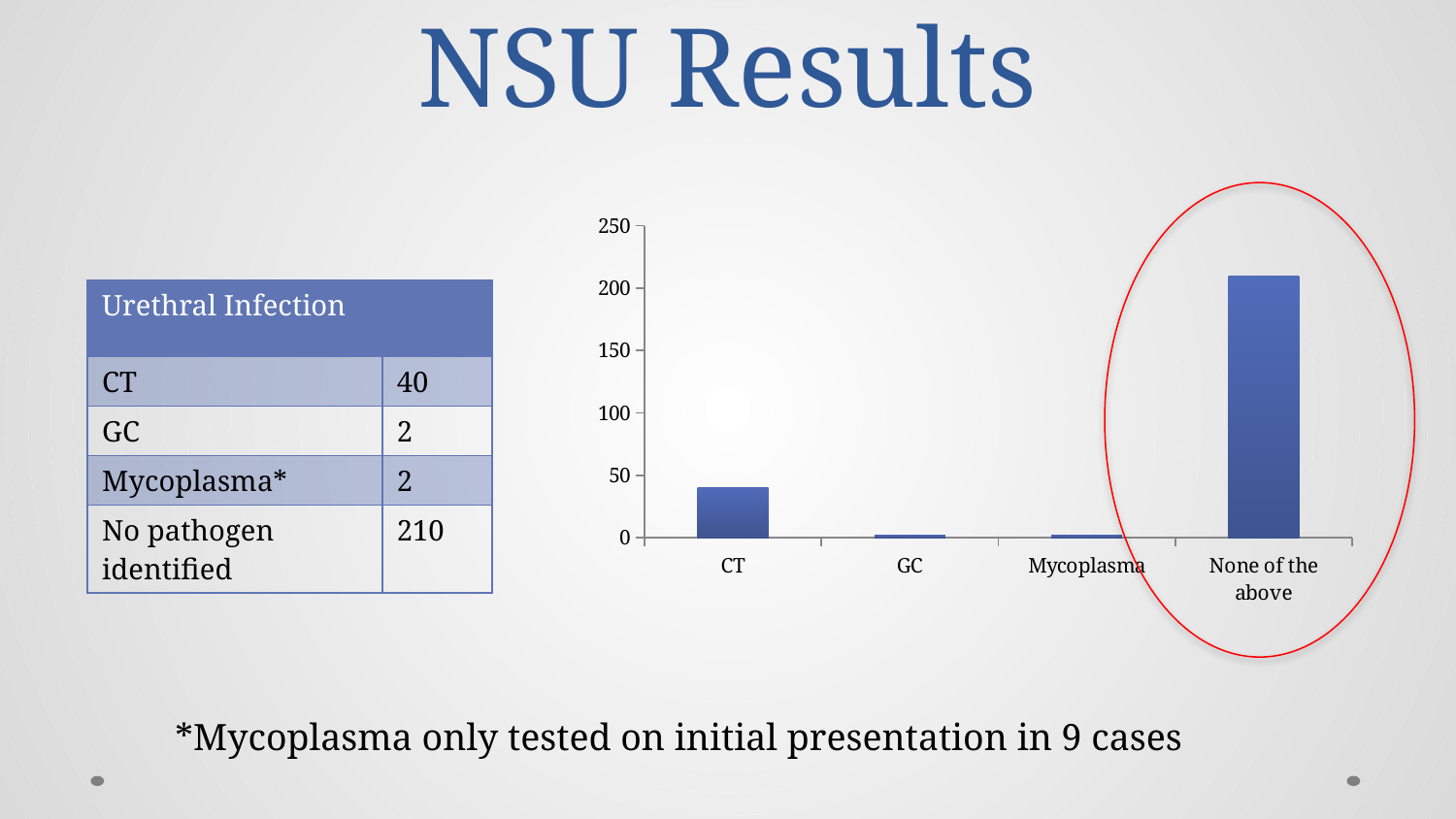
According to the slide, what is the value for the 'None of the above' (no pathogen identified) bar? 210 Which is larger, the bar for CT or the bar for GC? CT How many categories are shown on the x axis of the chart? 4 Is the value for CT greater or less than 50? less Which bar in the chart is circled in red? None of the above According to the slide, what is the value for GC? 2 According to the slide, what is the value for CT? 40 What kind of chart is shown on the slide? bar chart Is the value for GC greater or less than 50? less Which category has the highest bar in the chart? None of the above Which is larger, the bar for Mycoplasma or the bar for None of the above? None of the above Is the value for None of the above greater or less than 200? greater